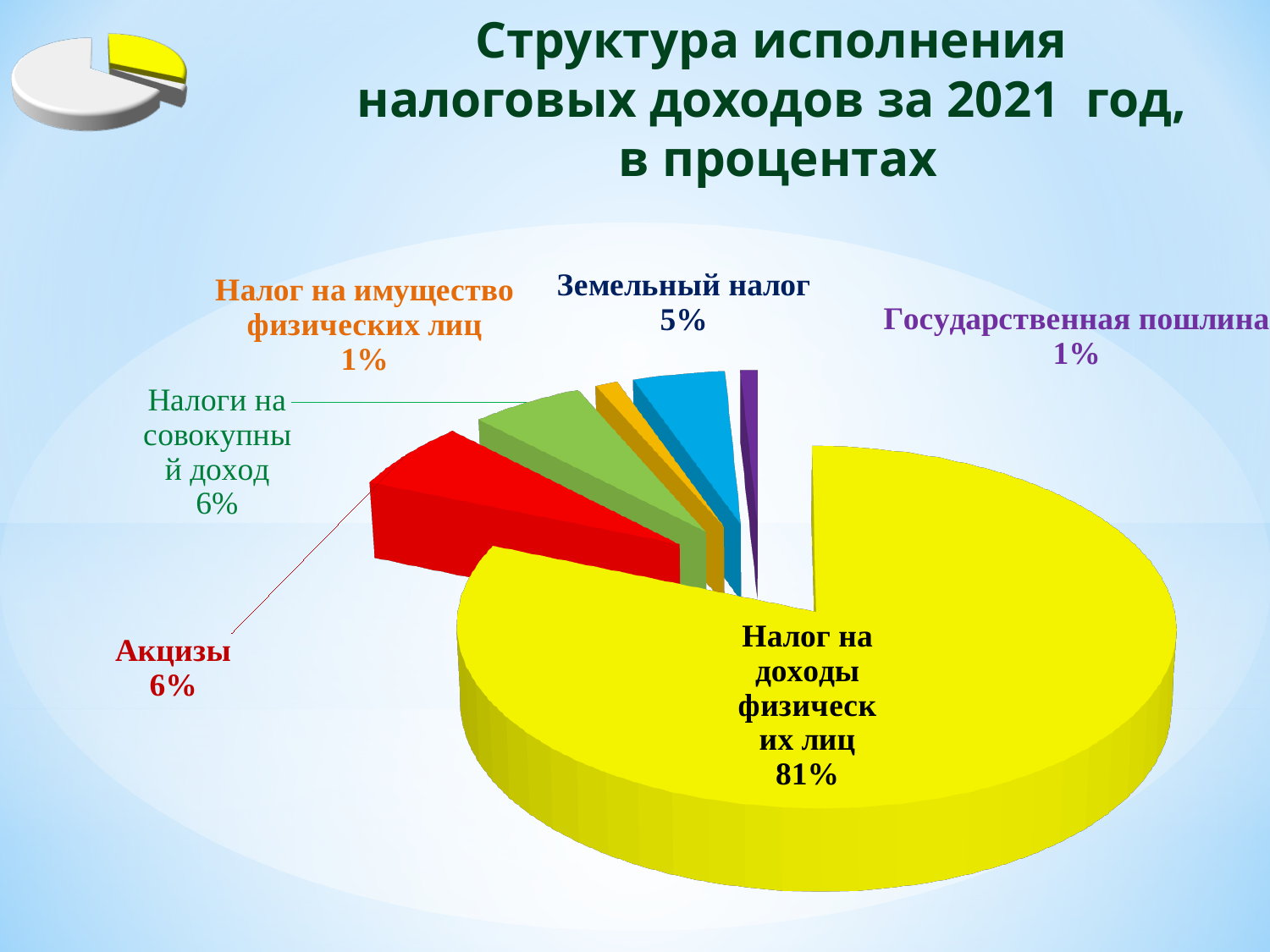
What is the value shown for Государственная пошлина? 1% What is the value shown for Земельный налог? 5% What share of the pie does Налог на доходы физических лиц have? 81% What colour is the slice for Налог на доходы физических лиц? Yellow How many slices does the pie chart have? 6 Which category has the largest slice of the pie? Налог на доходы физических лиц What kind of chart is shown on the slide? Pie chart What is the difference between the shares of Земельный налог and Налог на имущество физических лиц? 4% What is the value shown for Акцизы? 6% What is the difference between the shares of Налог на доходы физических лиц and Акцизы? 75% What is the value shown for Налоги на совокупный доход? 6% Which is larger, the share of Земельный налог or the share of Государственная пошлина? Земельный налог